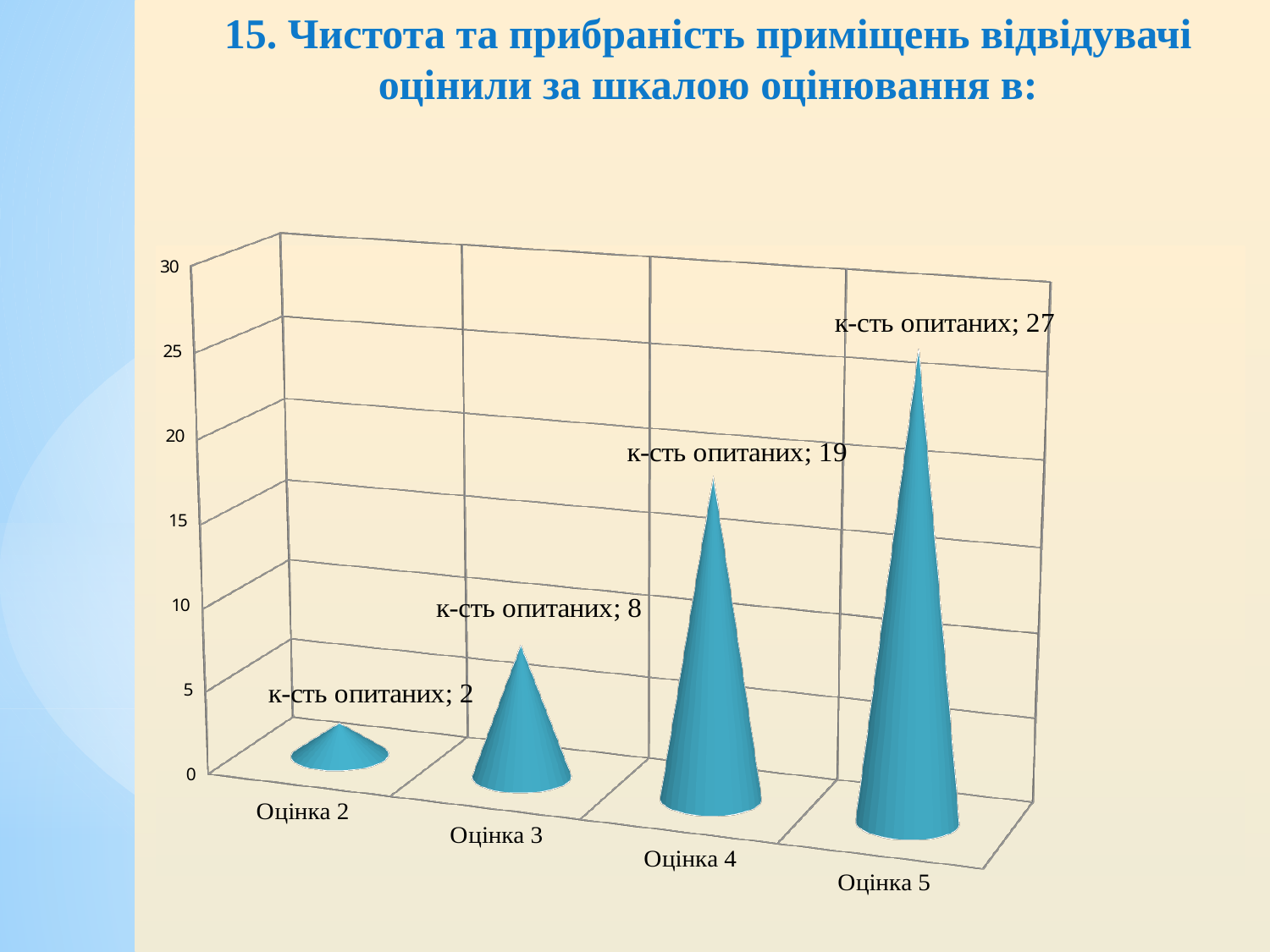
Which category has the highest value? Оцінка 5 Do the values rise or fall from Оцінка 2 to Оцінка 5? rise Which is larger, the value for Оцінка 3 or the value for Оцінка 4? Оцінка 4 How many categories are shown on the chart? 4 What is the value for Оцінка 3? 8 What is the value for Оцінка 5? 27 What is the value for Оцінка 2? 2 What is the difference between the values for Оцінка 5 and Оцінка 4? 8 What kind of chart is shown on the slide? bar chart Which category has the lowest value? Оцінка 2 What is the difference between the values for Оцінка 4 and Оцінка 3? 11 Is the value for Оцінка 4 greater or less than 15? greater